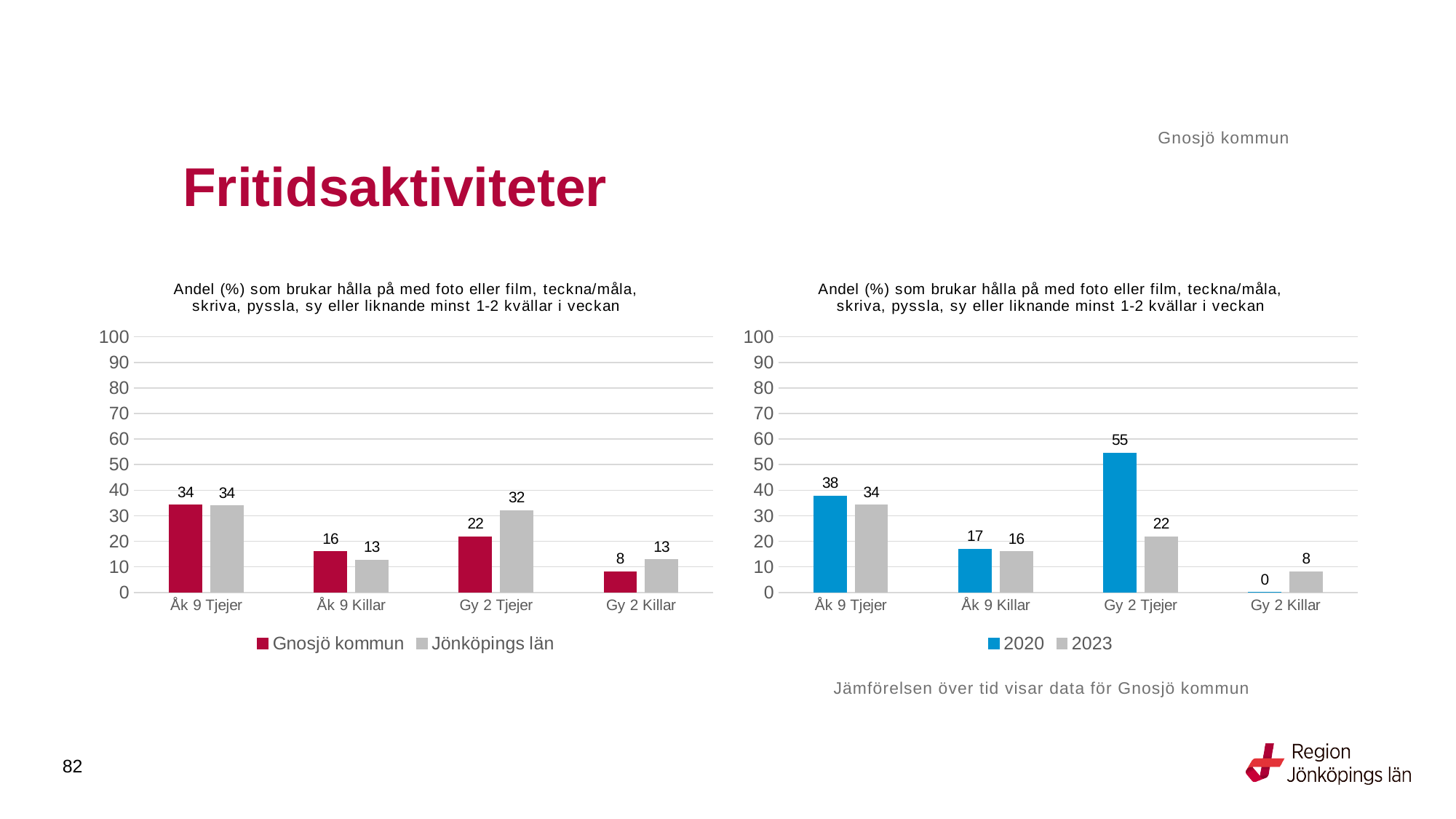
How many categories are shown on the x axis of the left chart? 4 What kind of chart is the left chart? Bar chart In the left chart, which category has the lowest value for Gnosjö kommun? Gy 2 Killar In the left chart, what is the value for Jönköpings län for Gy 2 Killar? 13 How many series does the legend of the right chart list? 2 In the left chart, which is larger for Gy 2 Tjejer: Gnosjö kommun or Jönköpings län? Jönköpings län In the right chart, what is the value for 2020 for Gy 2 Tjejer? 55 In the right chart, what is the difference between the 2020 and 2023 values for Gy 2 Tjejer? 33 In the right chart, which category has the highest value for 2020? Gy 2 Tjejer In the left chart, what is the value for Gnosjö kommun for Gy 2 Tjejer? 22 In the right chart, what is the value for 2020 for Gy 2 Killar? 0 In the right chart, what is the value for 2023 for Åk 9 Killar? 16